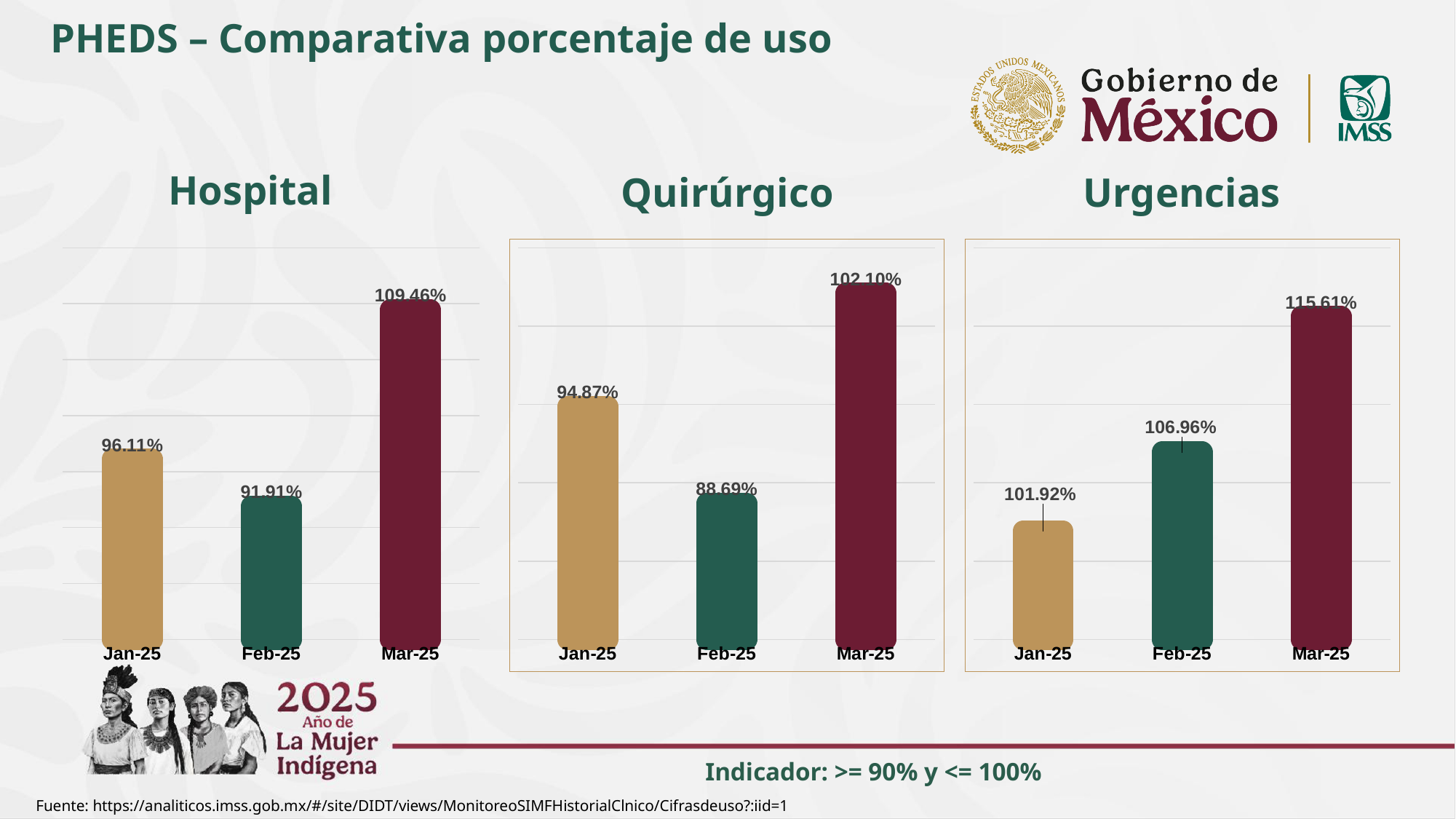
In the Hospital chart, what is the value for Mar-25? 109.46% In the Urgencias chart, do the values rise or fall from Jan-25 to Mar-25? rise In the Urgencias chart, which is larger, the value for Feb-25 or the value for Jan-25? Feb-25 In the Urgencias chart, which month has the highest value? Mar-25 In the Quirúrgico chart, what is the difference between the Mar-25 and Feb-25 values? 13.41% In the Urgencias chart, what is the value for Jan-25? 101.92% In the Hospital chart, what is the difference between the Mar-25 and Jan-25 values? 13.35% In the Quirúrgico chart, what is the value for Feb-25? 88.69% How many months are shown in the Hospital chart? 3 In the Quirúrgico chart, which month has the highest value? Mar-25 What kind of chart is the Quirúrgico chart? bar chart In the Hospital chart, which month has the lowest value? Feb-25